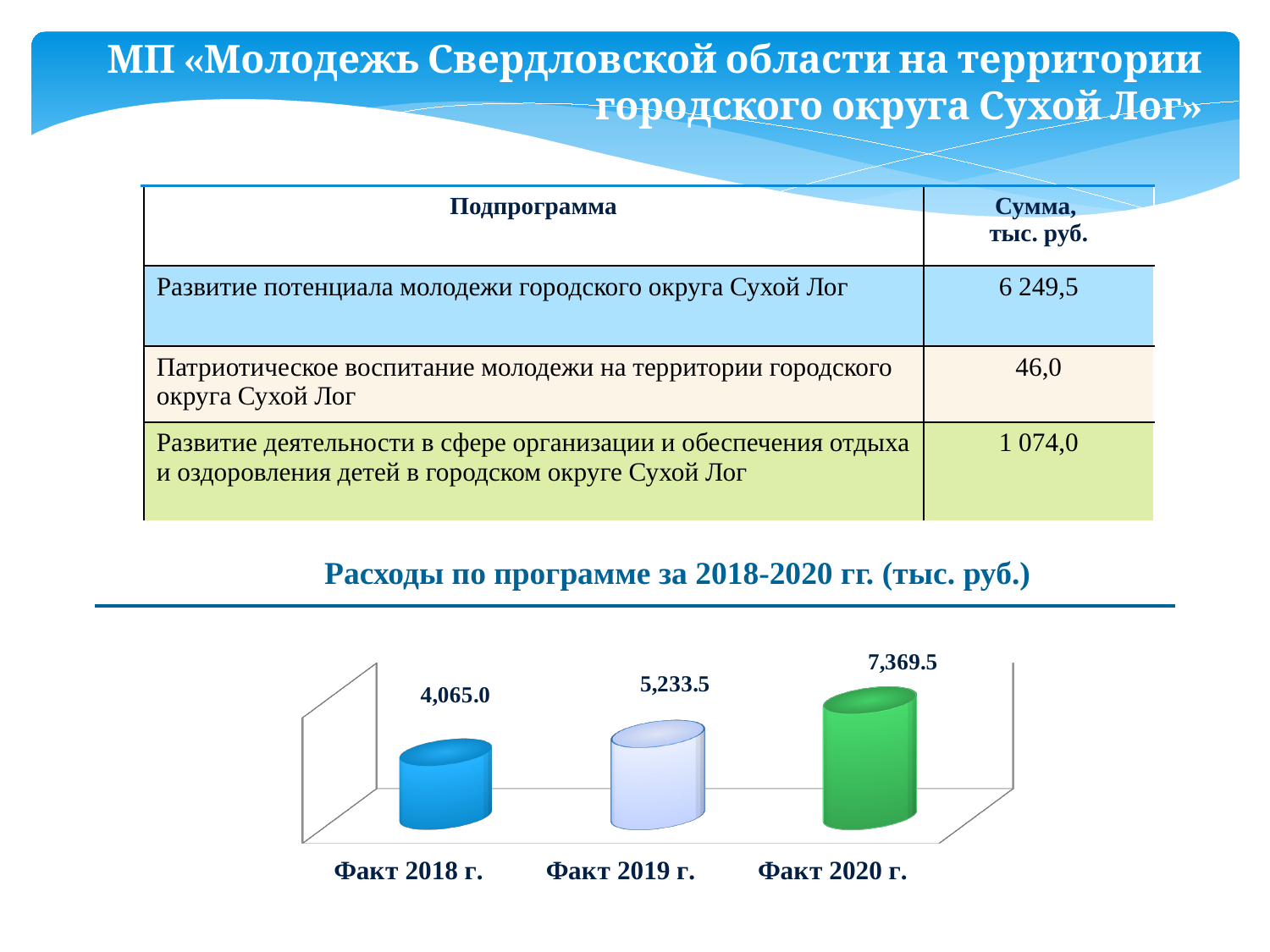
What is the difference between the values for Факт 2019 г. and Факт 2018 г.? 1,168.5 Which year has the highest value in the chart? Факт 2020 г. What is the value for Факт 2019 г. in the chart? 5,233.5 How many categories are shown in the chart? 3 Which is larger, the value for Факт 2019 г. or Факт 2020 г.? Факт 2020 г. What kind of chart is shown on the slide? Bar chart What is the value for Факт 2020 г. in the chart? 7,369.5 What is the value for Факт 2018 г. in the chart? 4,065.0 What is the difference between the values for Факт 2020 г. and Факт 2018 г.? 3,304.5 Which year has the lowest value in the chart? Факт 2018 г. Do the values rise or fall from Факт 2018 г. to Факт 2020 г.? Rise What is the title of the chart? Расходы по программе за 2018-2020 гг. (тыс. руб.)